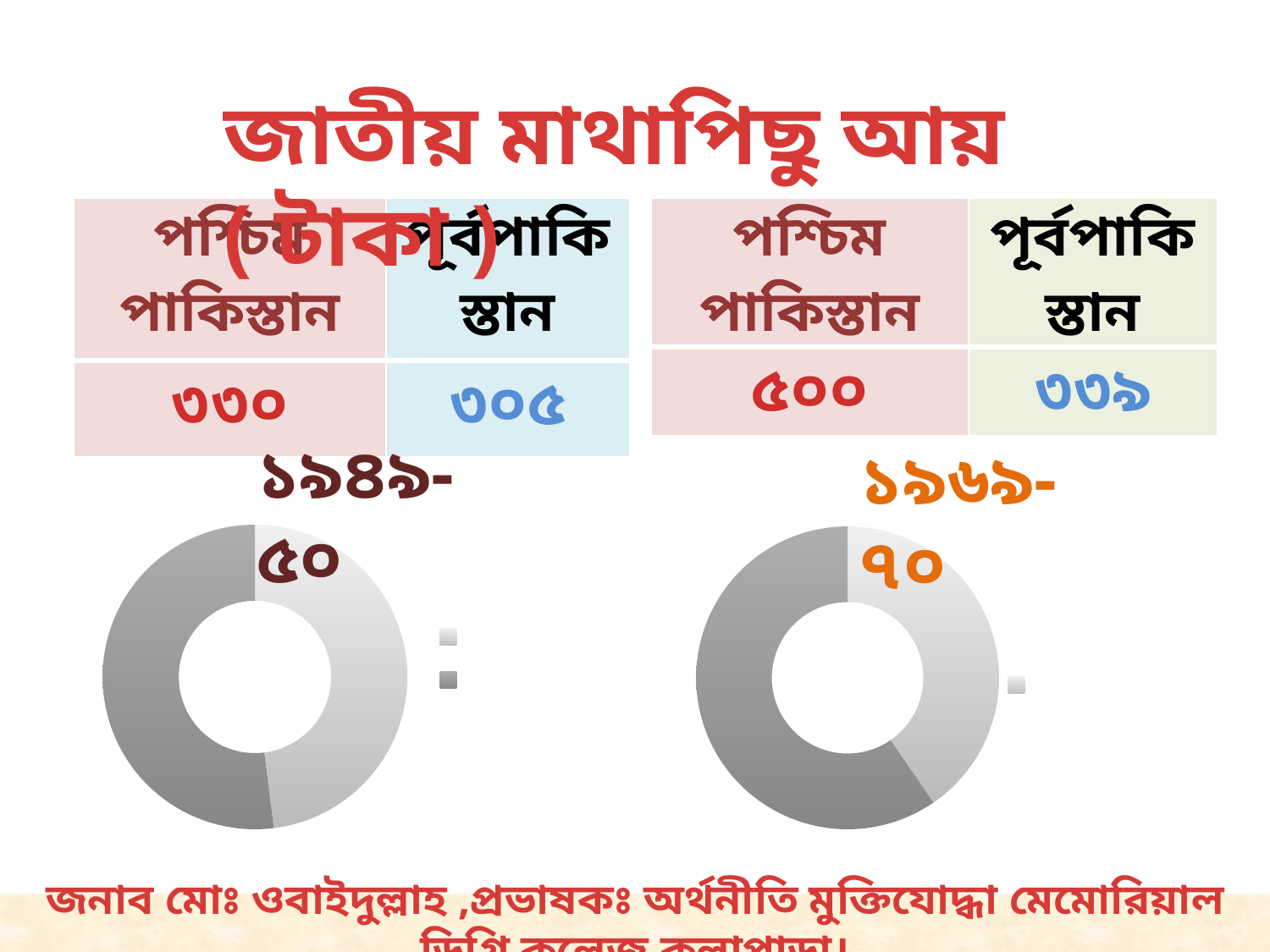
How many slices does the left doughnut chart have? 2 How many slices does the right doughnut chart have? 2 What kind of chart is shown on the left side of the slide? doughnut (pie) chart In the right doughnut chart, is the darker grey slice larger or smaller than the lighter grey slice? larger Which year label appears above the left doughnut chart? ১৯৪৯-৫০ What kind of chart is shown on the right side of the slide? doughnut (pie) chart How many doughnut charts are on the slide? 2 What is the title written above the charts on the slide? জাতীয় মাথাপিছু আয় (টাকা)